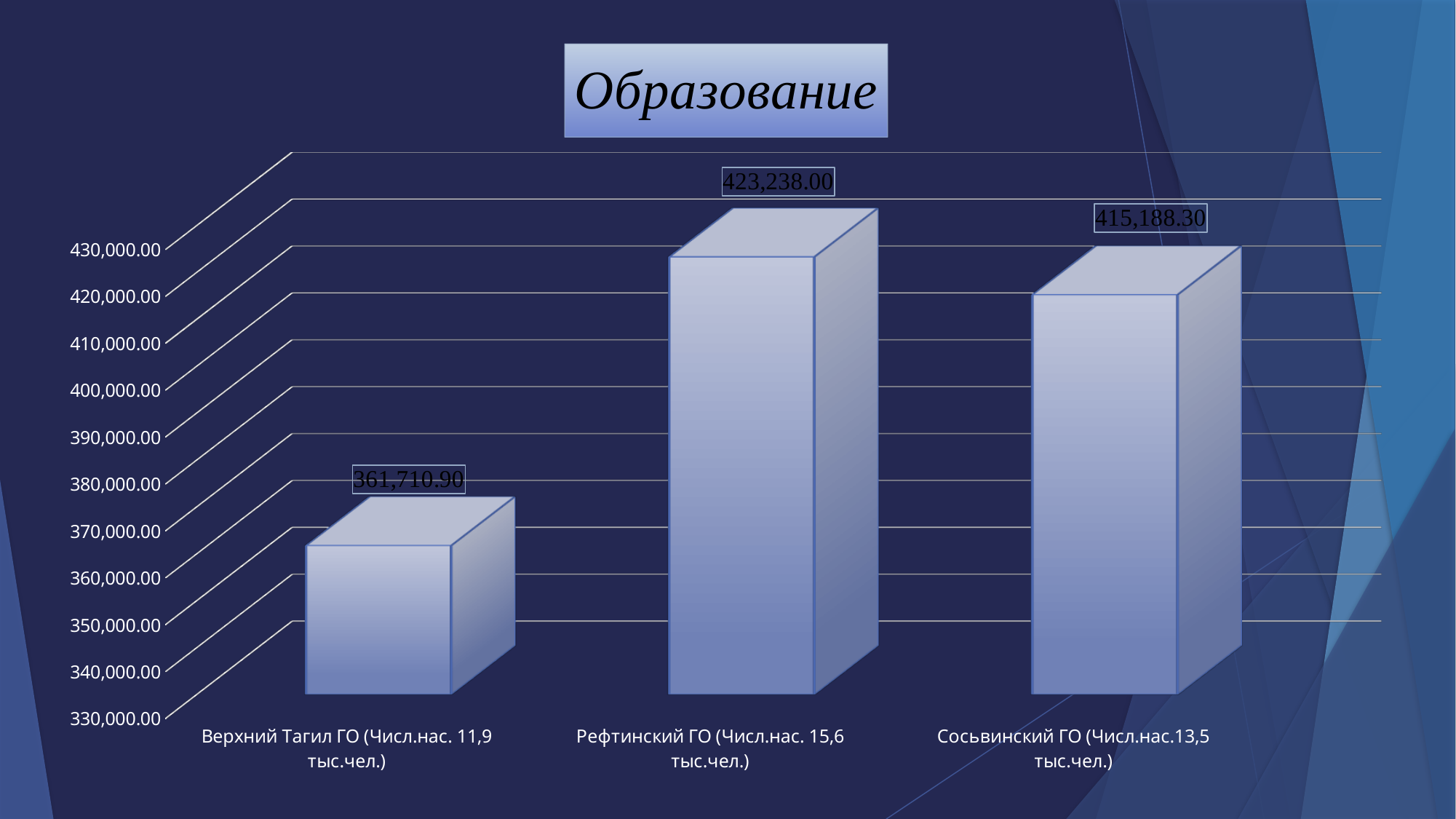
What is the difference between the values for Рефтинский ГО and Верхний Тагил ГО? 61,527.10 What is the title of the chart? Образование Which category has the lowest value? Верхний Тагил ГО What is the value for Сосьвинский ГО? 415,188.30 What is the value for Рефтинский ГО? 423,238.00 What kind of chart is shown on the slide? bar chart Which is larger, the value for Сосьвинский ГО or the value for Верхний Тагил ГО? Сосьвинский ГО How many categories are shown in the chart? 3 Is the value for Верхний Тагил ГО greater or less than 370,000.00? less Which category has the highest value? Рефтинский ГО What is the difference between the values for Рефтинский ГО and Сосьвинский ГО? 8,049.70 What is the value for Верхний Тагил ГО? 361,710.90